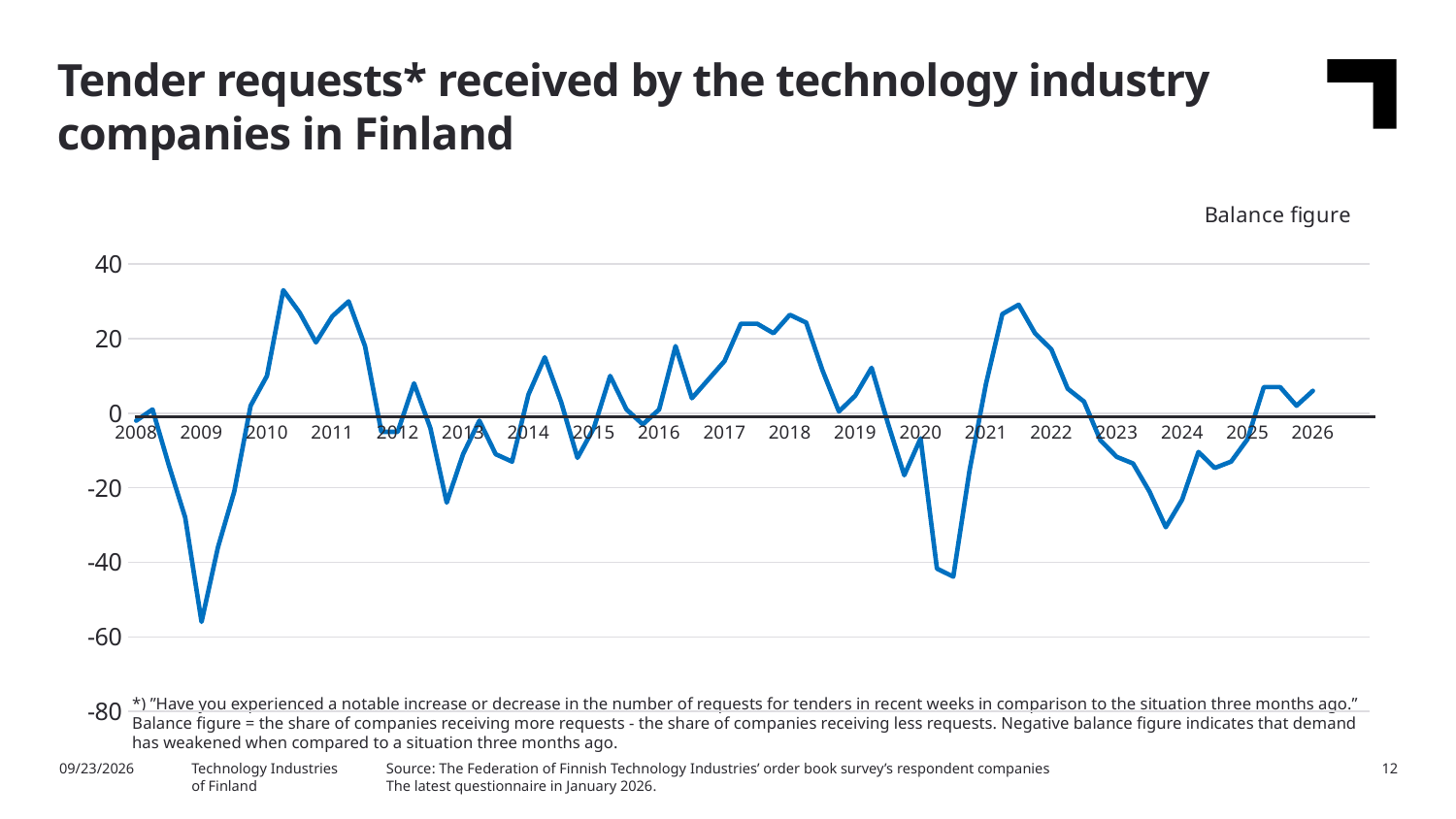
Is the value of the line at the start of 2026 greater or less than 0? greater How many data series are plotted in the chart? 1 What measure is plotted on the vertical axis, according to the label above the chart? Balance figure What kind of chart is shown on the slide? Line chart In which year does the line reach its lowest point? 2009 How many year labels are shown along the x axis? 19 What is the title of the chart on the slide? Tender requests* received by the technology industry companies in Finland Is the lowest value of the line around 2020 greater or less than -40? less Is the lowest value of the line in 2009 greater or less than -40? less Which is lower, the trough of the line in 2009 or the trough around 2020? 2009